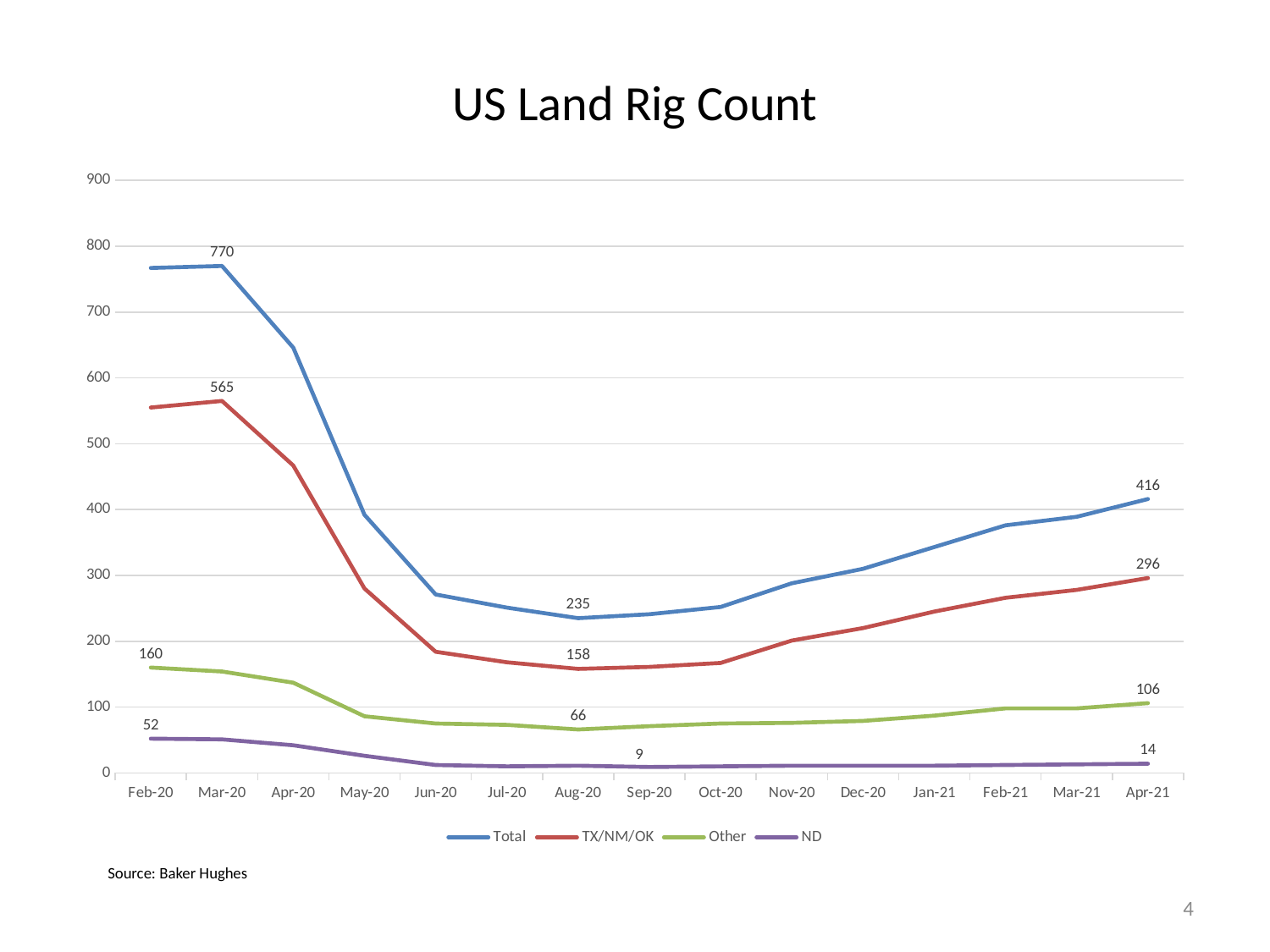
What is the ND value in Sep-20? 9 What is the difference between the Total value in Mar-20 and the Total value in Aug-20? 535 What is the Total value in Mar-20? 770 What is the Other value in Feb-20? 160 Which is larger, the Other value in Apr-21 or the Other value in Aug-20? Apr-21 How many months are shown on the x axis? 15 Is the TX/NM/OK value in Nov-20 greater or less than 300? less What is the TX/NM/OK value in Apr-21? 296 What is the difference between the TX/NM/OK value in Mar-20 and in Apr-21? 269 Is the Total value in Apr-20 greater or less than 600? greater How many series does the legend list? 4 What kind of chart is shown? line chart